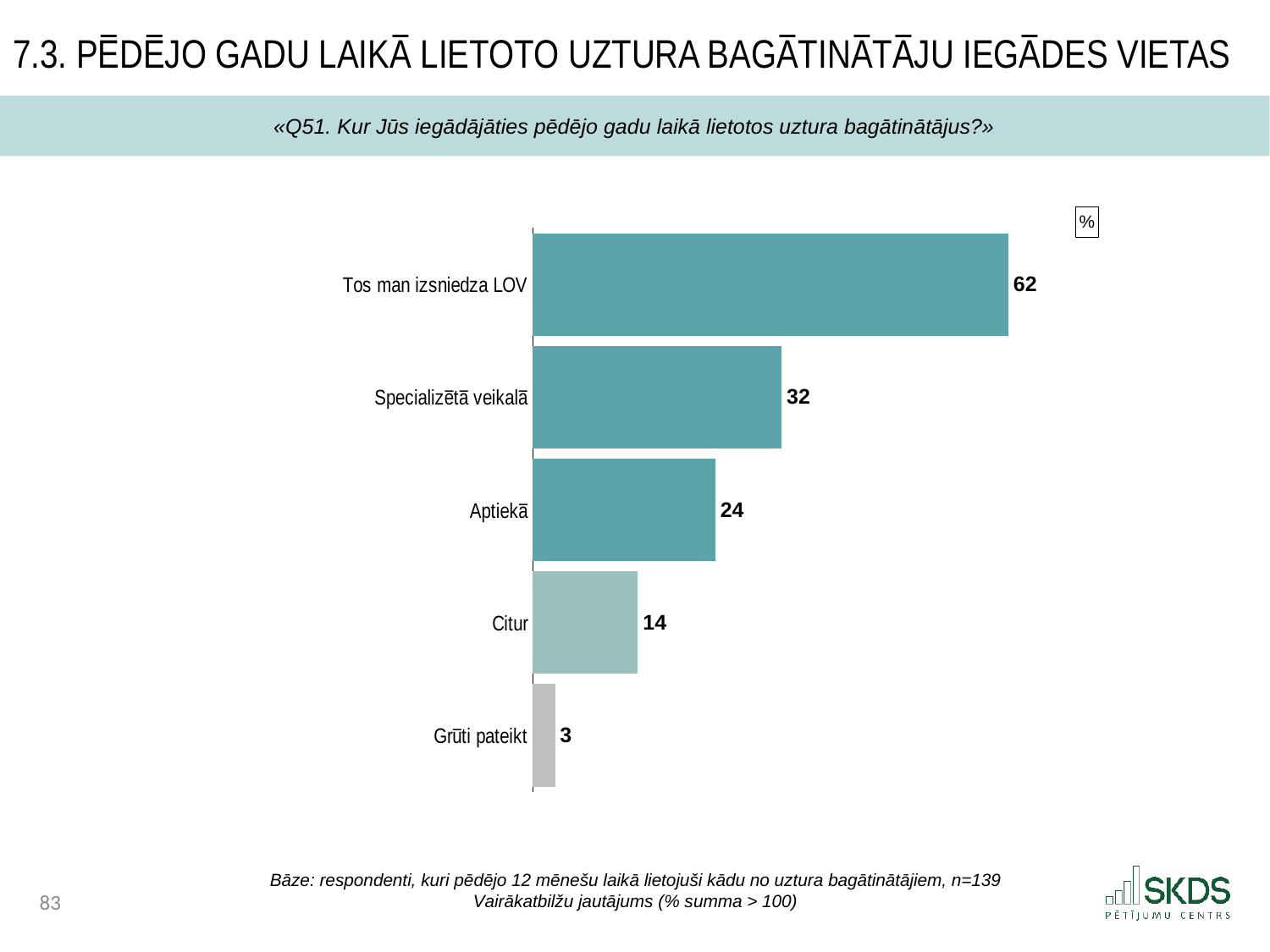
What is the difference between the values for "Aptiekā" and "Citur"? 10 What is the value for "Tos man izsniedza LOV"? 62 Which is larger, the value for "Specializētā veikalā" or the value for "Aptiekā"? Specializētā veikalā Which category has the highest value? Tos man izsniedza LOV Which category has the lowest value? Grūti pateikt How many categories are shown in the chart? 5 What is the value for "Citur"? 14 What is the difference between the values for "Tos man izsniedza LOV" and "Specializētā veikalā"? 30 What is the value for "Aptiekā"? 24 What is the value for "Grūti pateikt"? 3 What is the value for "Specializētā veikalā"? 32 What kind of chart is shown on the slide? Bar chart